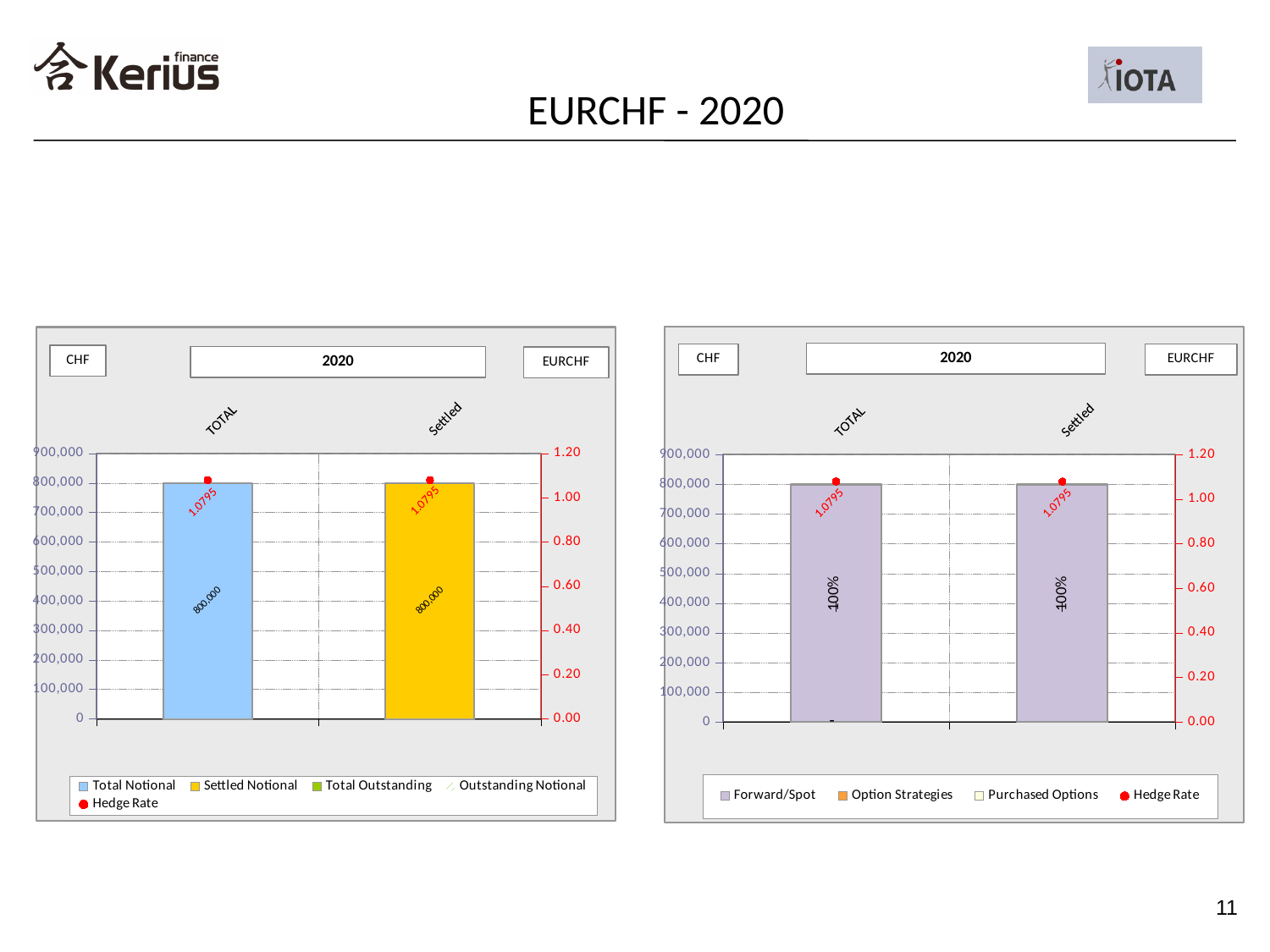
How many series does the legend of the right chart list? 4 In the left chart, is the Total Notional value for TOTAL greater or less than 700,000? greater In the left chart, what is the Total Notional value for TOTAL? 800,000 In the left chart, what is the Settled Notional value for Settled? 800,000 What type of chart is the right chart? combination bar and line chart In the left chart, what is the Hedge Rate shown for TOTAL? 1.0795 How many categories are shown on the x axis of the left chart? 2 In the right chart, what percentage label is shown on the Forward/Spot bar for TOTAL? 100% How many series does the legend of the left chart list? 5 In the right chart, is the Hedge Rate for TOTAL greater or less than 1.00? greater In the left chart, what is the difference between the Total Notional for TOTAL and the Settled Notional for Settled? 0 In the right chart, what is the Hedge Rate shown for Settled? 1.0795